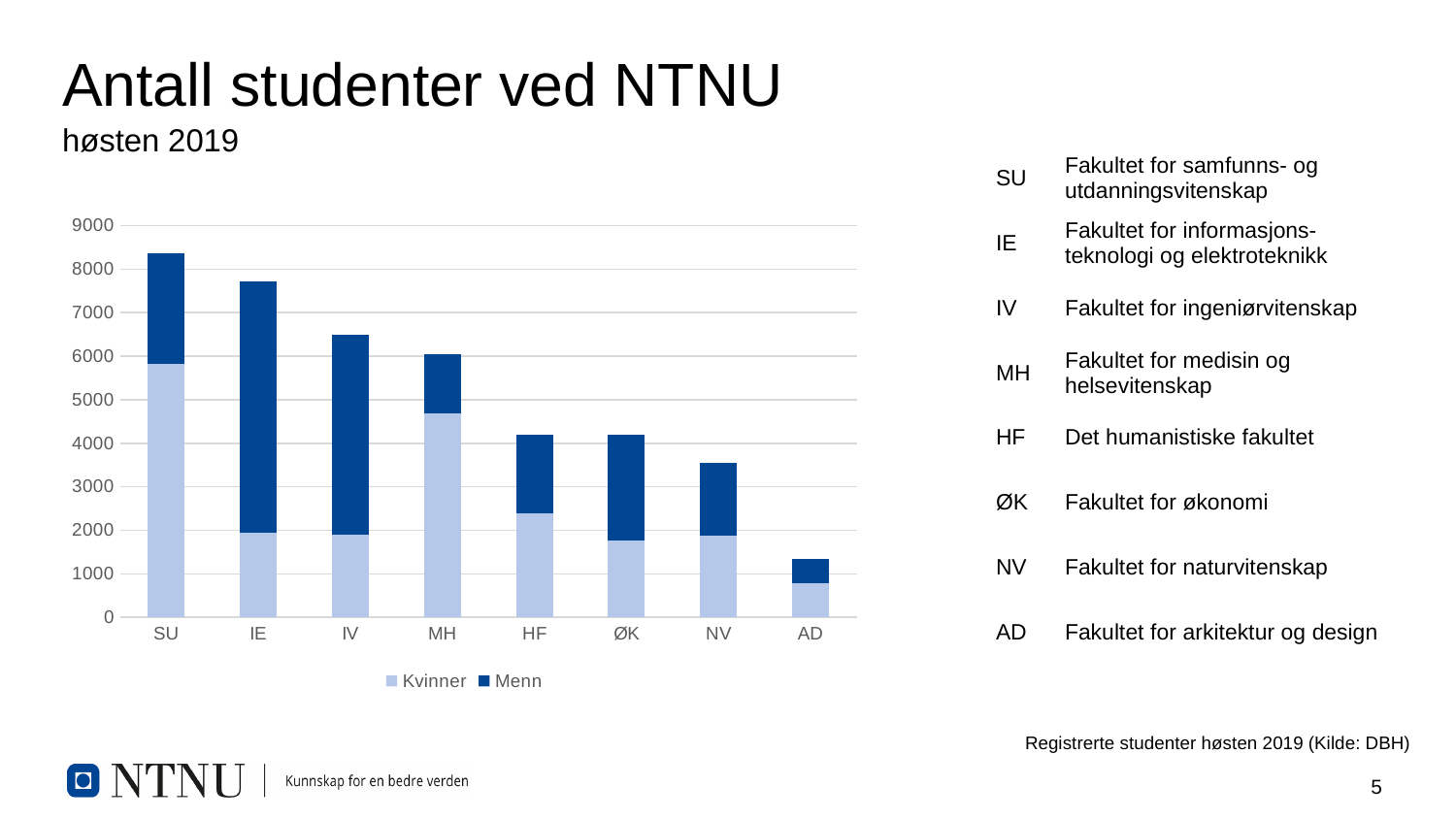
Is the Kvinner value for MH greater or less than 4000? greater How many series does the chart's legend list? 2 What kind of chart is shown on the slide? Stacked bar chart Which faculty has the highest total number of students in the chart? SU Is the total number of students for SU greater or less than 8000? greater Do the total bar heights generally rise or fall from left to right along the x axis? fall How many faculties (categories) are shown on the x axis of the chart? 8 Is the total number of students for AD greater or less than 2000? less Which faculty has the lowest total number of students in the chart? AD Which has more students in total, SU or IE? SU What are the two series named in the chart's legend? Kvinner and Menn